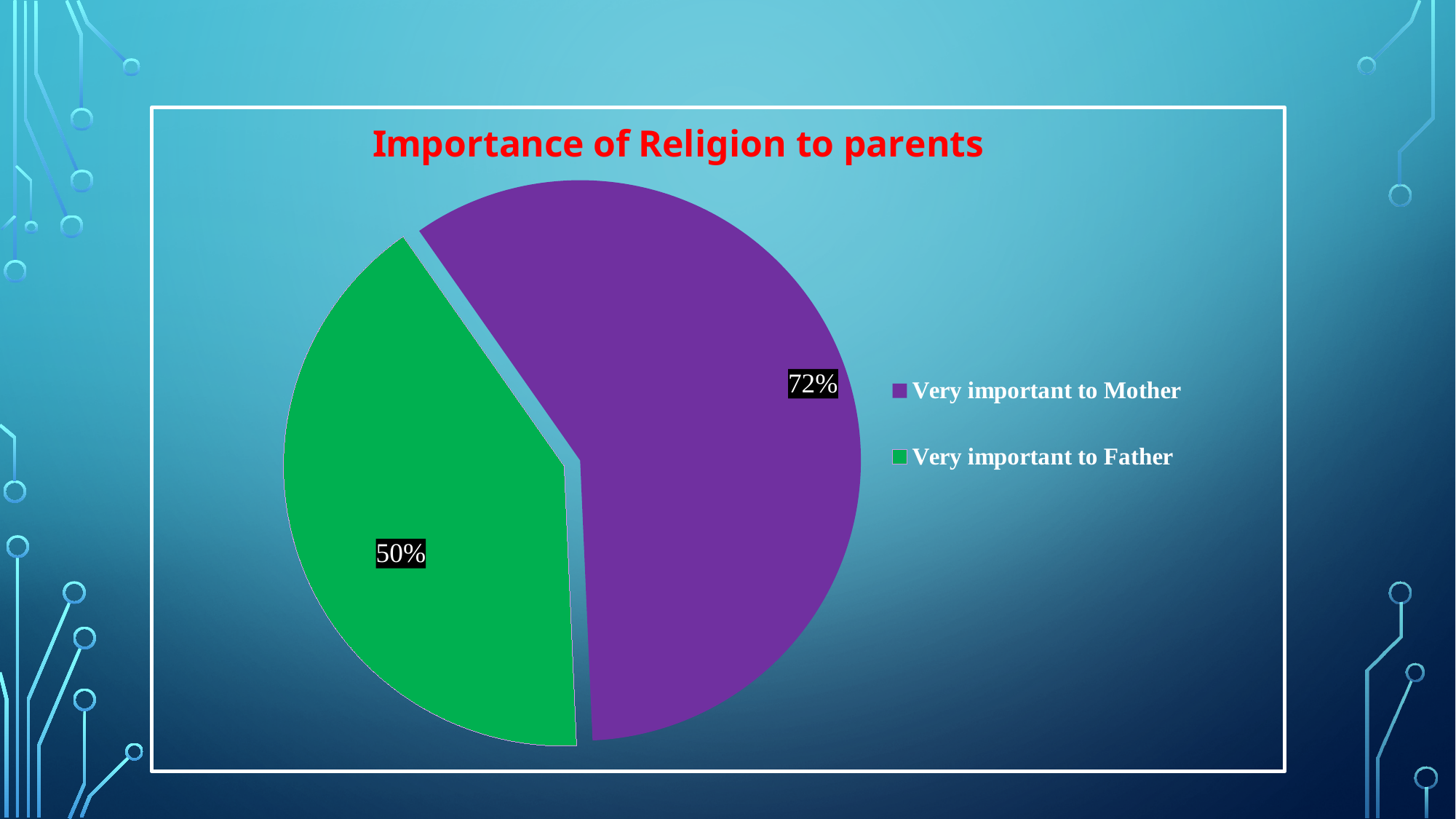
What colour is the 'Very important to Father' slice? Green What kind of chart is shown on the slide? Pie chart What is the title of the chart? Importance of Religion to parents Which is larger: the value for 'Very important to Mother' or 'Very important to Father'? Very important to Mother How many slices does the pie chart have? 2 How many entries does the legend list? 2 Which category has the highest value in the pie chart? Very important to Mother What value is shown for the 'Very important to Father' slice? 50% What is the difference between the 'Very important to Mother' value and the 'Very important to Father' value? 22% Which category has the lowest value in the pie chart? Very important to Father What value is shown for the 'Very important to Mother' slice? 72%